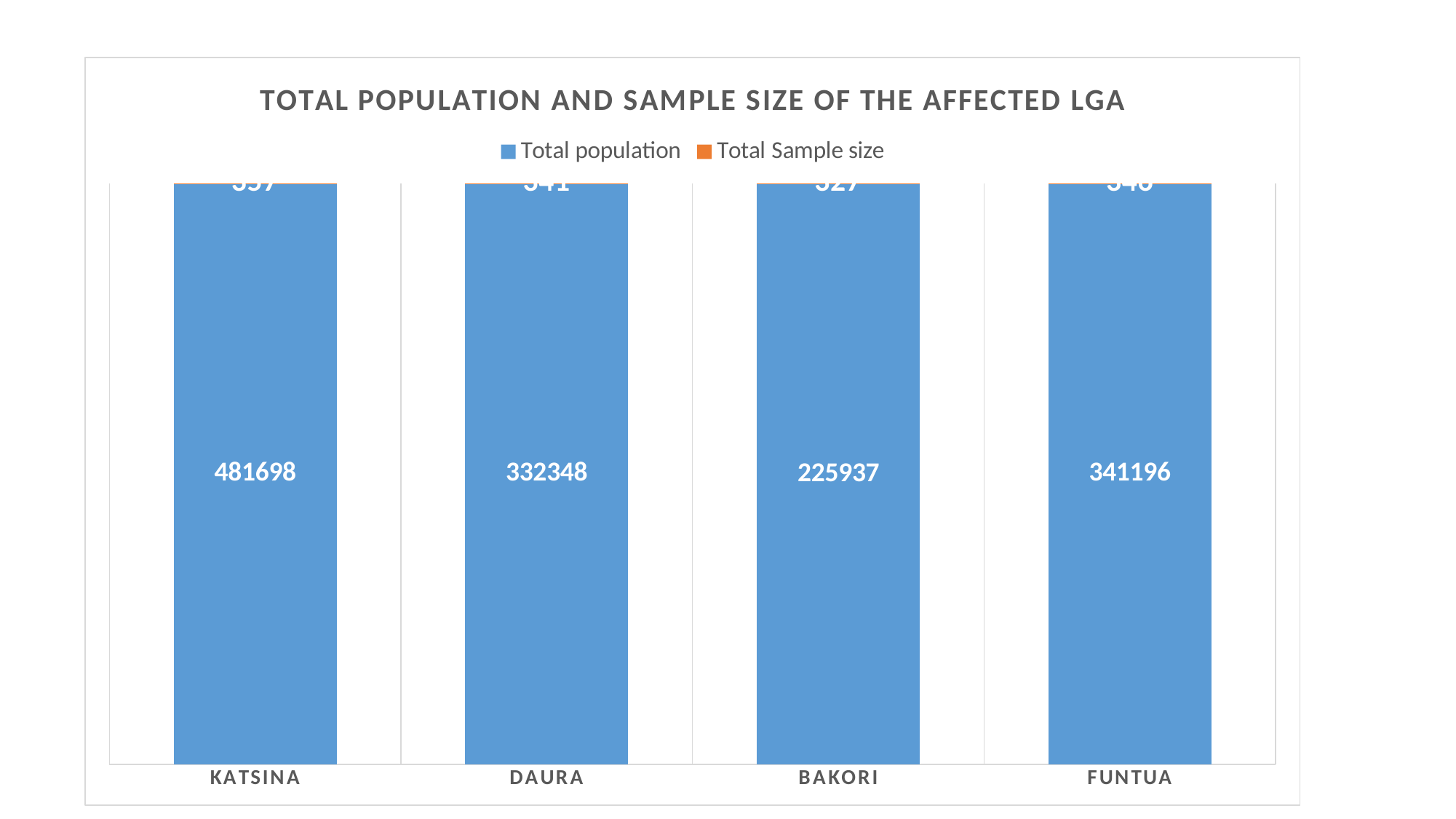
What is the Total population for Bakori? 225937 Which has the larger Total population, Daura or Funtua? Funtua What is the Total population for Funtua? 341196 What is the difference in Total population between Katsina and Daura? 149350 How many series does the legend list? 2 How many LGAs are shown on the x axis? 4 Which LGA has the highest Total population? Katsina What is the difference in Total population between Funtua and Bakori? 115259 What is the Total population for Katsina? 481698 Which LGA has the lowest Total population? Bakori What is the Total population for Daura? 332348 What is the title of the chart? TOTAL POPULATION AND SAMPLE SIZE OF THE AFFECTED LGA